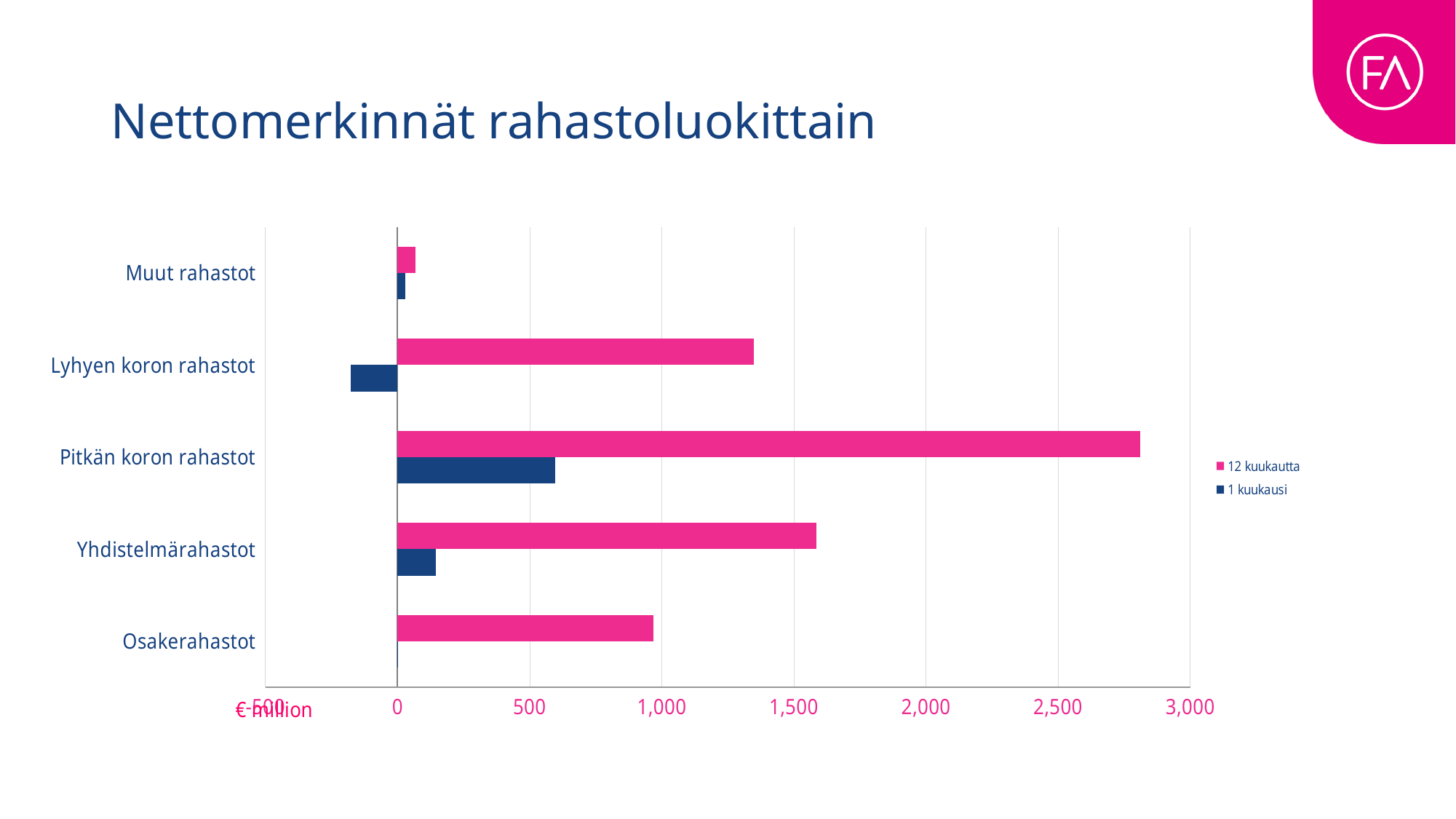
Which is larger: the 12 kuukautta value for Yhdistelmärahastot or for Lyhyen koron rahastot? Yhdistelmärahastot Which category has the lowest value for the 1 kuukausi series? Lyhyen koron rahastot How many fund categories are shown on the chart? 5 Which category has the highest value for the 12 kuukautta series? Pitkän koron rahastot Which colour represents the 1 kuukausi series in the legend? dark blue Is the 1 kuukausi value for Lyhyen koron rahastot greater or less than 0? less Which category has the highest value for the 1 kuukausi series? Pitkän koron rahastot What is the title of the slide? Nettomerkinnät rahastoluokittain Is the 12 kuukautta value for Pitkän koron rahastot greater or less than 2,500? greater Is the 12 kuukautta value for Osakerahastot greater or less than 1,000? less What kind of chart is shown on the slide? bar chart How many series does the legend list? 2